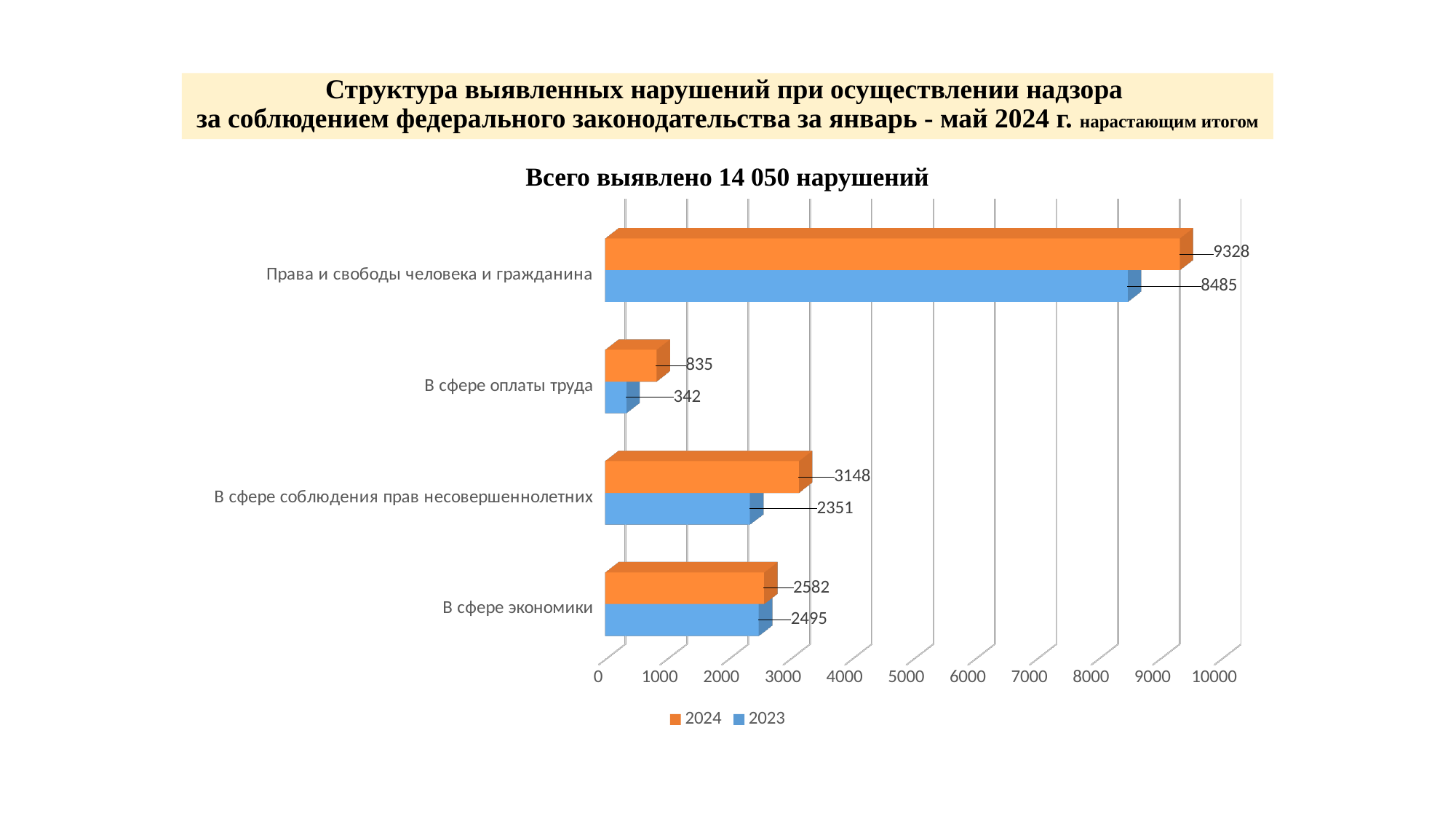
What is the 2023 value for "В сфере оплаты труда"? 342 What is the 2024 value for "В сфере соблюдения прав несовершеннолетних"? 3148 How many categories are shown on the chart? 4 What is the 2023 value for "В сфере экономики"? 2495 Which category has the lowest 2023 value? В сфере оплаты труда Which is larger for "В сфере соблюдения прав несовершеннолетних": the 2024 value or the 2023 value? 2024 What kind of chart is shown on the slide? Bar chart What is the difference between the 2024 and 2023 values for "Права и свободы человека и гражданина"? 843 What is the 2024 value for "Права и свободы человека и гражданина"? 9328 Which category has the highest 2024 value? Права и свободы человека и гражданина How many series does the legend list? 2 What is the difference between the 2024 and 2023 values for "В сфере оплаты труда"? 493